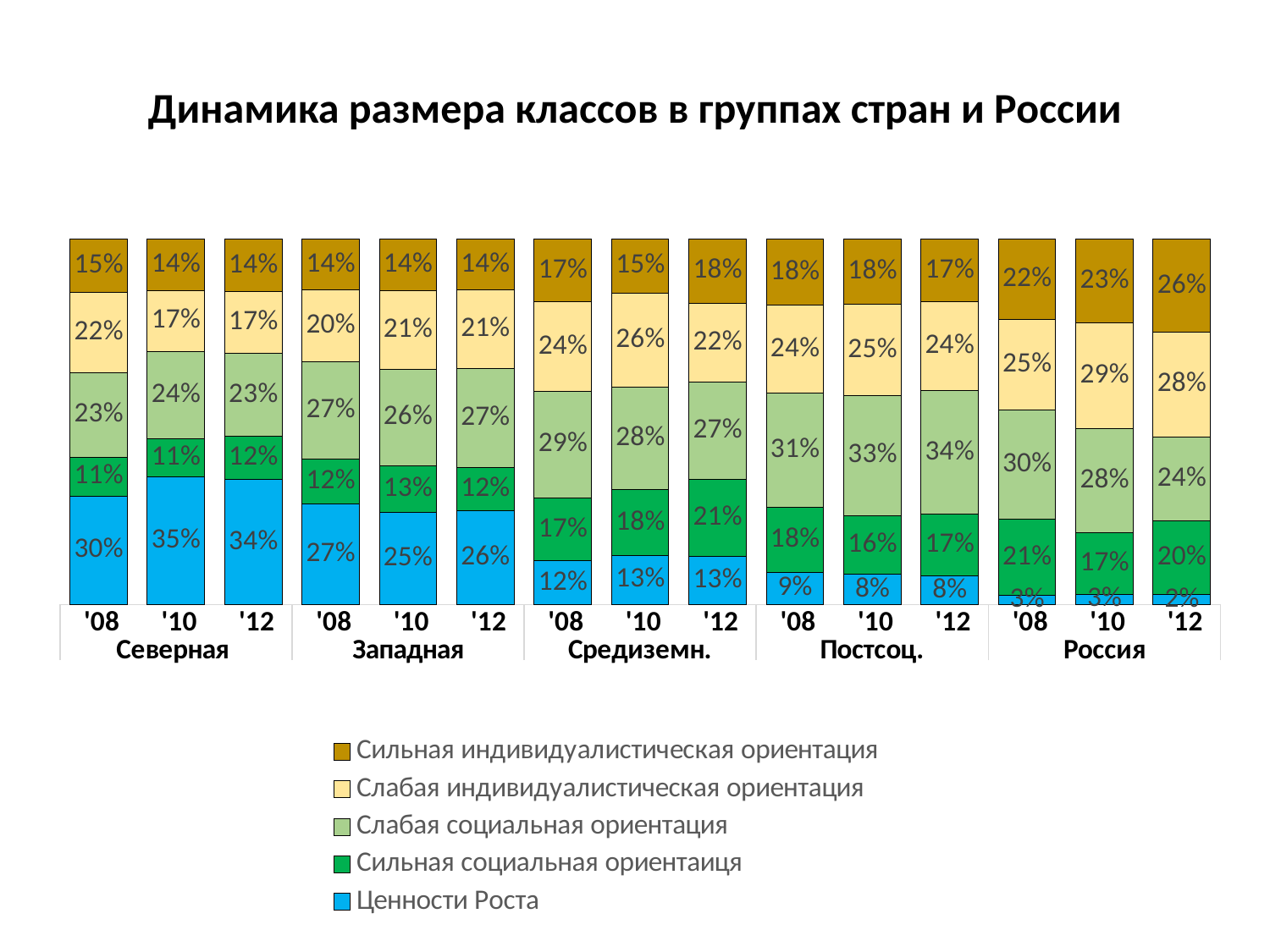
What is the value of Сильная индивидуалистическая ориентация for Россия in '12? 26% What is the difference between the Ценности Роста values for Северная and Средиземн. in '08? 18% What kind of chart is shown on the slide? Stacked bar chart How many bars are plotted in the chart? 15 Which country group has the lowest Ценности Роста value in '12? Россия What is the title of the chart? Динамика размера классов в группах стран и России Which is larger: Сильная социальная ориентация for Средиземн. in '12 or for Постсоц. in '12? Средиземн. in '12 How does the Сильная индивидуалистическая ориентация value for Россия change from '08 to '12? It rises What is the value of Слабая социальная ориентация for Постсоц. in '12? 34% What is the value of Ценности Роста for Северная in '10? 35% Which country group has the highest Ценности Роста value in '08? Северная How many series does the legend list? 5